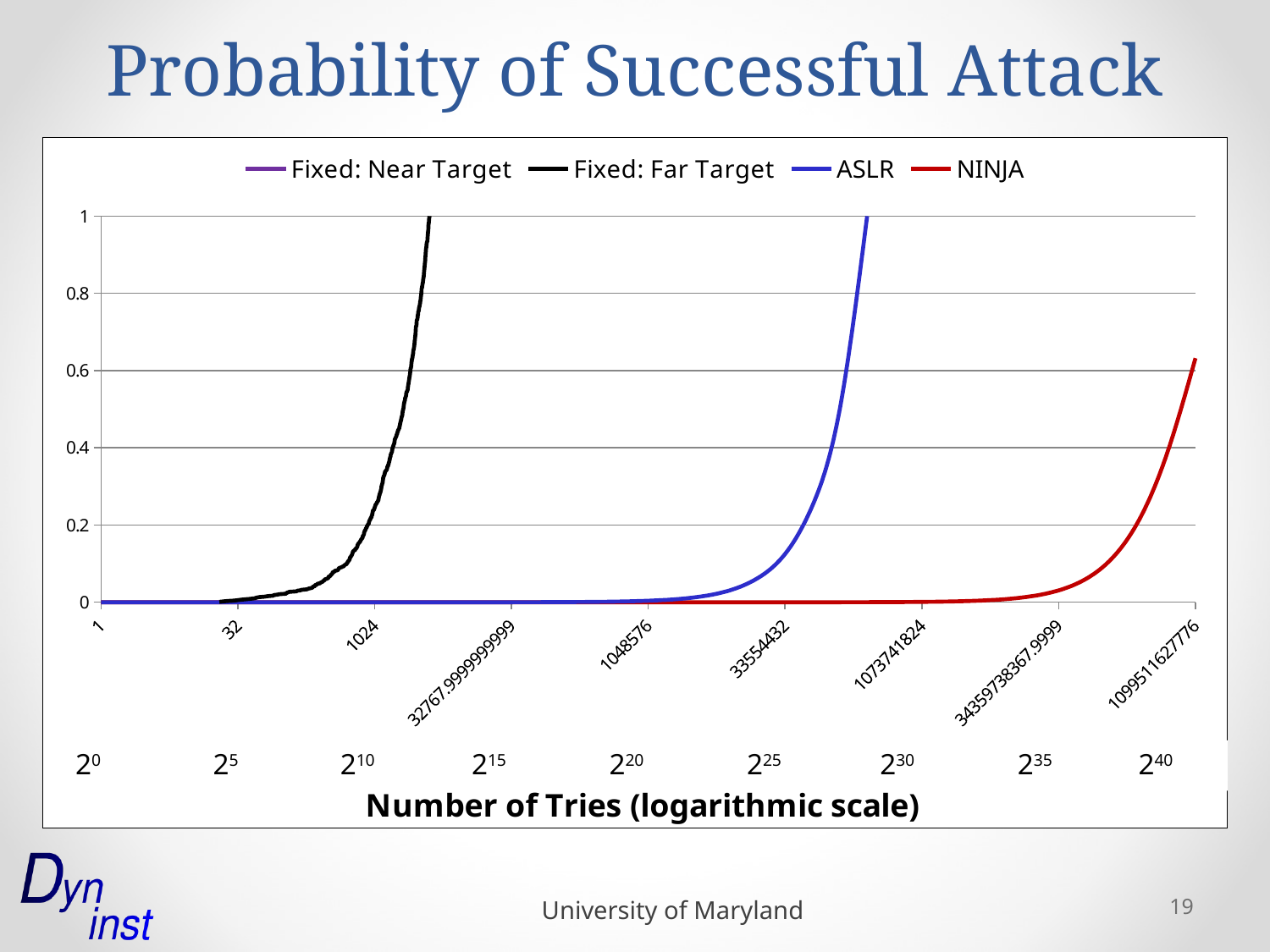
Which series requires the most tries before its probability rises above 0 (furthest to the right)? NINJA At 33554432 tries (2^25), which series has the higher probability, ASLR or NINJA? ASLR What is the label of the x axis? Number of Tries (logarithmic scale) Do the probability values rise or fall as the number of tries increases along the x axis? rise Is the value for NINJA at 1099511627776 tries (2^40) greater or less than 0.4? greater At 1024 tries (2^10), which series has the higher probability, Fixed: Far Target or ASLR? Fixed: Far Target What kind of chart is shown on the slide? line chart Which series reaches a probability of 1 with the fewest tries (furthest to the left)? Fixed: Far Target What is the title of the chart? Probability of Successful Attack Is the value for Fixed: Far Target at 1024 tries (2^10) greater or less than 0.2? less How many series does the legend list? 4 Is the value for ASLR at 33554432 tries (2^25) greater or less than 0.2? less